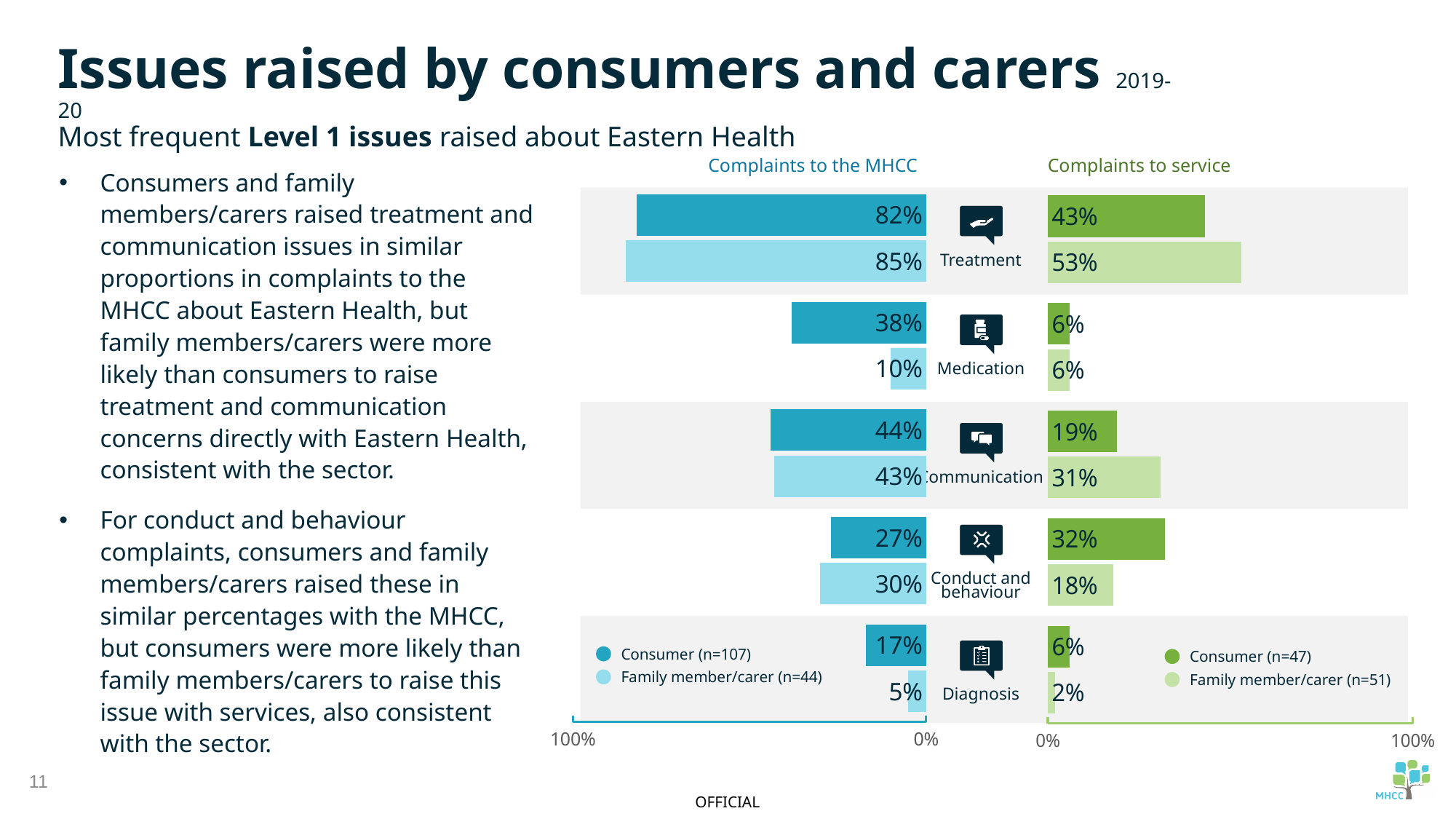
In the 'Complaints to service' chart, which is larger for Conduct and behaviour: the Consumer value or the Family member/carer value? Consumer In the 'Complaints to the MHCC' chart, which issue has the lowest Family member/carer value? Diagnosis How many issue categories are shown in the 'Complaints to the MHCC' chart? 5 How many series does the legend of the 'Complaints to service' chart list? 2 In the 'Complaints to service' chart, which issue has the highest Consumer value? Treatment In the 'Complaints to service' chart, what is the Family member/carer value for Communication? 31% In the 'Complaints to service' chart, what is the difference between the Family member/carer and Consumer values for Treatment? 10% According to the legend of the 'Complaints to service' chart, how many family members/carers are in the sample? n=51 In the 'Complaints to the MHCC' chart, what is the Family member/carer value for Diagnosis? 5% What type of chart is the 'Complaints to the MHCC' chart? Bar chart In the 'Complaints to the MHCC' chart, what is the difference between the Consumer and Family member/carer values for Medication? 28% In the 'Complaints to the MHCC' chart, what percentage of consumer complaints raised Treatment? 82%